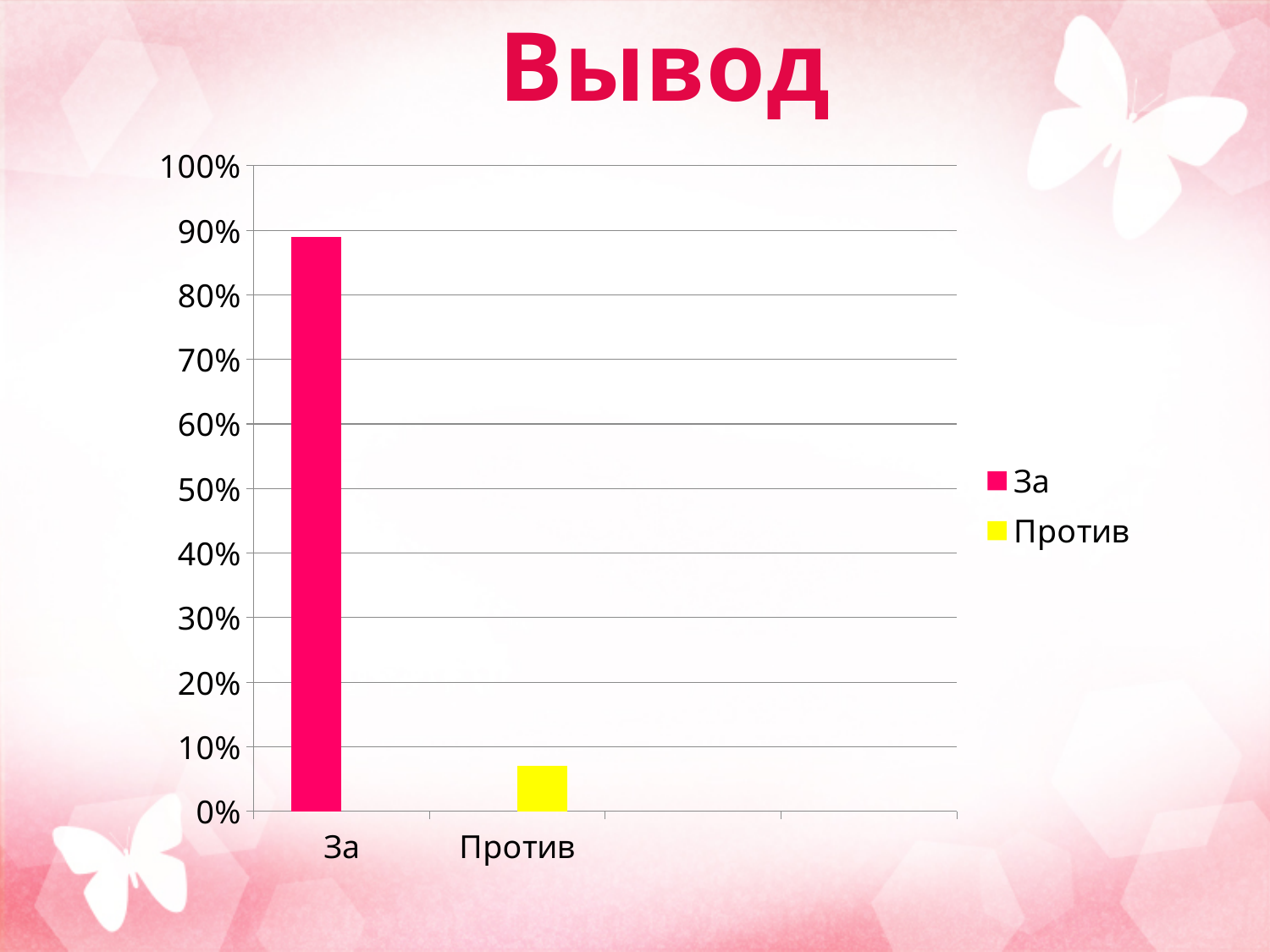
Which category has the highest value in the chart? За Is the value for Против greater or less than 10%? less Which category has the lowest value in the chart? Против What is the title shown above the chart on the slide? Вывод What colour is the bar for Против in the chart? yellow Is the value for За greater or less than 80%? greater What is the highest value shown on the chart's vertical axis? 100% What kind of chart is shown on the slide? bar chart How many series does the chart's legend list? 2 Which is larger, the value for За or the value for Против? За How many categories are shown on the x axis of the chart? 2